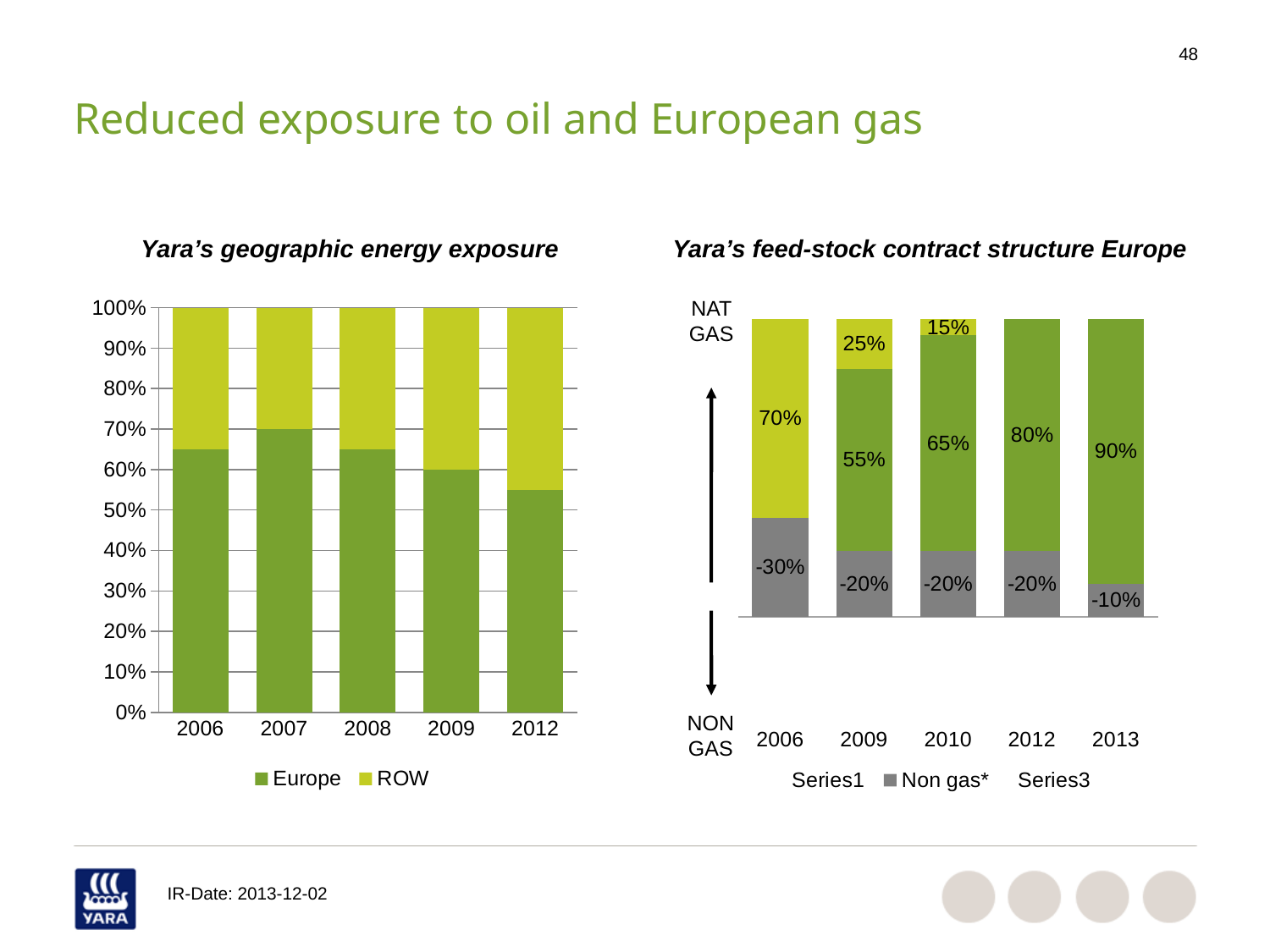
In 'Yara's feed-stock contract structure Europe', which is larger: the green segment value for 2009 or for 2010? 2010 In 'Yara's feed-stock contract structure Europe', what is the Non gas* value for 2006? -30% In 'Yara's feed-stock contract structure Europe', how many series does the legend list? 3 What kind of chart is 'Yara's geographic energy exposure'? Stacked bar chart In 'Yara's feed-stock contract structure Europe', what is the value labelled on the green segment for 2013? 90% In 'Yara's geographic energy exposure', how many years are shown on the x axis? 5 In 'Yara's geographic energy exposure', how many series does the legend list? 2 In 'Yara's geographic energy exposure', what is the Europe share in 2007? 70% In 'Yara's geographic energy exposure', is the Europe share in 2012 greater or less than 60%? less In 'Yara's geographic energy exposure', does the Europe share rise or fall from 2007 to 2012? fall In 'Yara's geographic energy exposure', which two series are listed in the legend? Europe and ROW In 'Yara's feed-stock contract structure Europe', which year has the highest green segment value? 2013